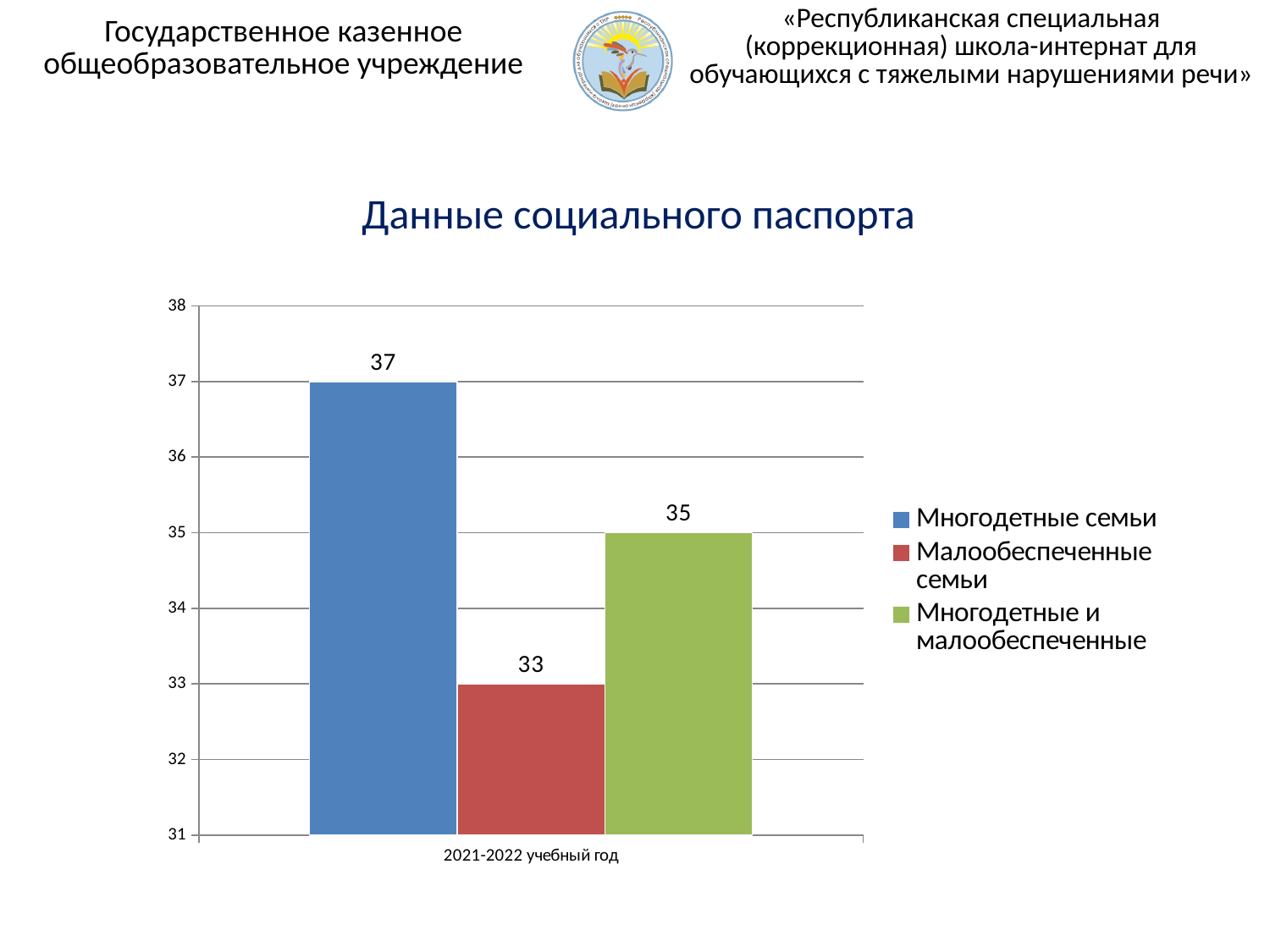
What is the difference between the values for Многодетные и малообеспеченные and Малообеспеченные семьи? 2 What is the value for Многодетные и малообеспеченные in 2021-2022 учебный год? 35 What colour is the bar for Малообеспеченные семьи? red What kind of chart is shown on the slide? bar chart What is the value for Многодетные семьи in 2021-2022 учебный год? 37 What is the value for Малообеспеченные семьи in 2021-2022 учебный год? 33 Which series has the highest value? Многодетные семьи How many series does the legend list? 3 Which series has the lowest value? Малообеспеченные семьи Which is larger: the value for Многодетные и малообеспеченные or the value for Малообеспеченные семьи? Многодетные и малообеспеченные What is the title of the chart? Данные социального паспорта What is the difference between the values for Многодетные семьи and Малообеспеченные семьи? 4